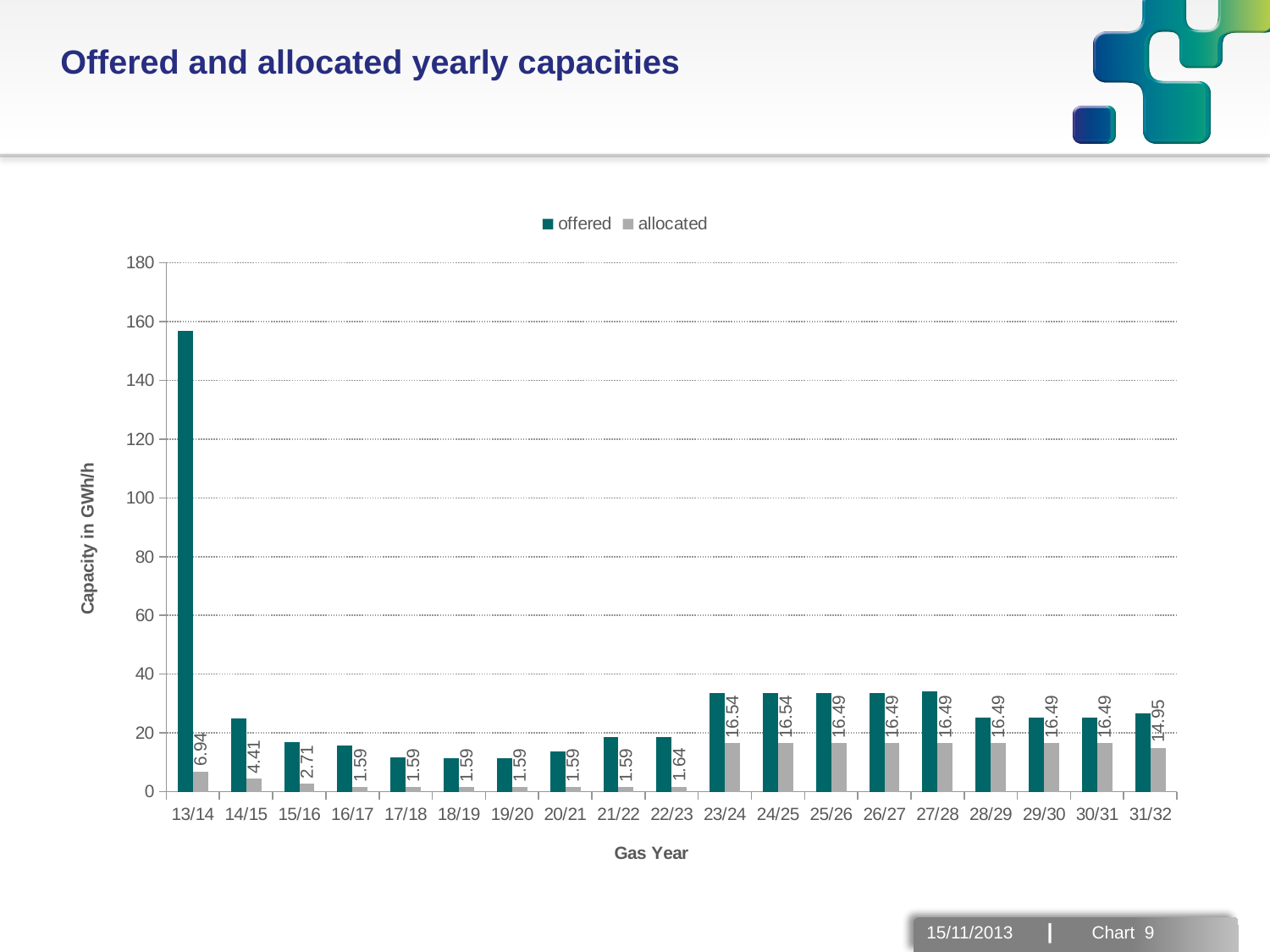
What is the allocated capacity for gas year 13/14? 6.94 How many gas years are shown on the x axis? 19 How many series does the legend list? 2 What is the allocated capacity for gas year 23/24? 16.54 What is the allocated capacity for gas year 31/32? 14.95 What is the lowest allocated capacity value shown on the chart? 1.59 Is the offered capacity for gas year 23/24 greater or less than 40? less Which gas year has the highest offered capacity? 13/14 What kind of chart is shown on the slide? bar chart Is the offered capacity for gas year 13/14 greater or less than 140? greater What is the difference between the allocated capacity in 13/14 and in 14/15? 2.53 Which gas year has the larger offered capacity, 13/14 or 14/15? 13/14